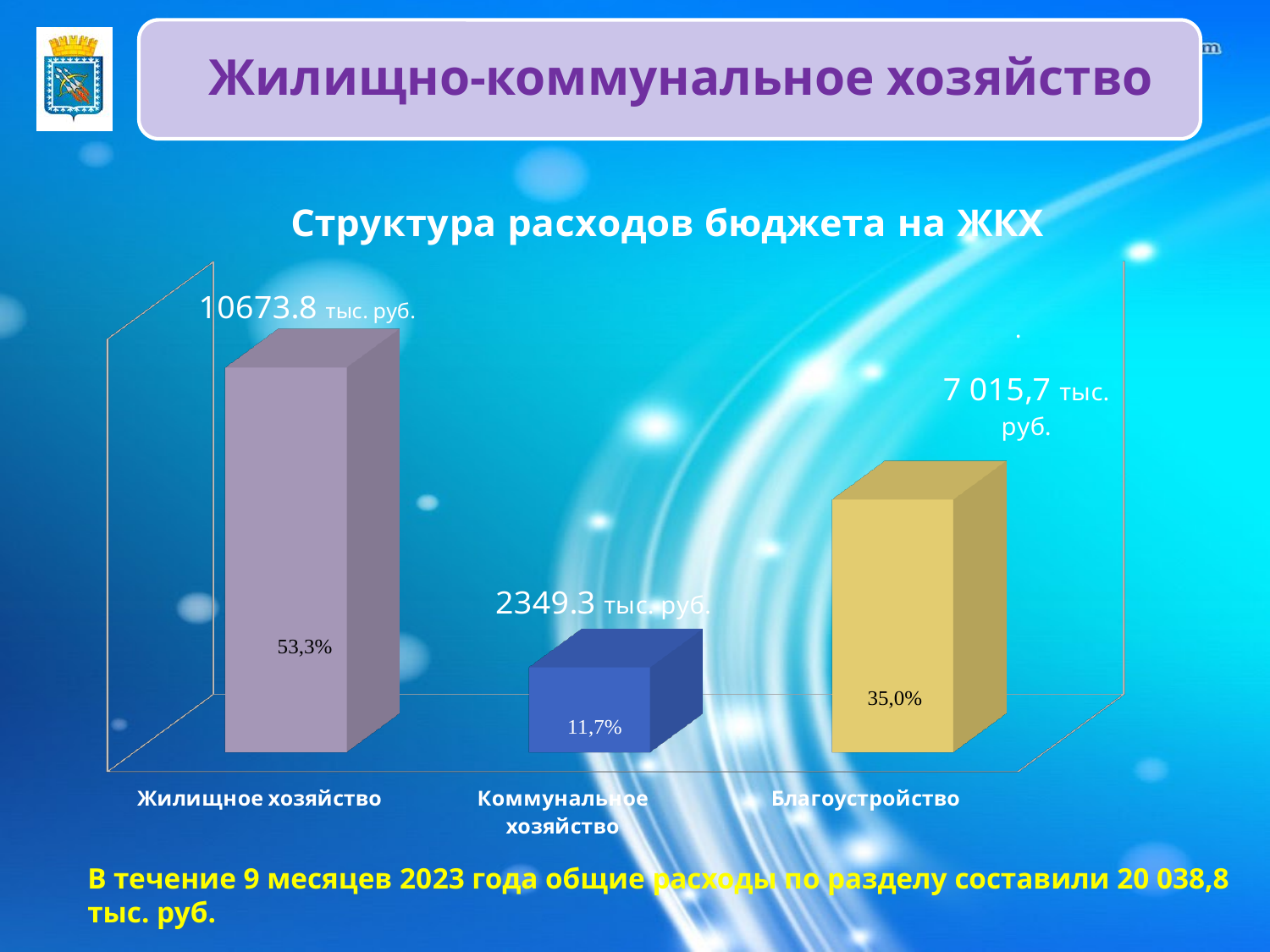
What type of chart is shown on the slide? Bar chart How many categories are shown in the chart? 3 What is the value for Благоустройство? 7 015,7 тыс. руб. What is the value for Коммунальное хозяйство? 2349.3 тыс. руб. What is the difference in percentage share between Жилищное хозяйство and Благоустройство? 18,3% What percentage share is shown for Благоустройство? 35,0% Which is larger, the value for Благоустройство or the value for Коммунальное хозяйство? Благоустройство What is the value for Жилищное хозяйство? 10673.8 тыс. руб. Which category has the highest value? Жилищное хозяйство Which category has the lowest value? Коммунальное хозяйство What percentage share is shown for Коммунальное хозяйство? 11,7% What is the title of the chart? Структура расходов бюджета на ЖКХ